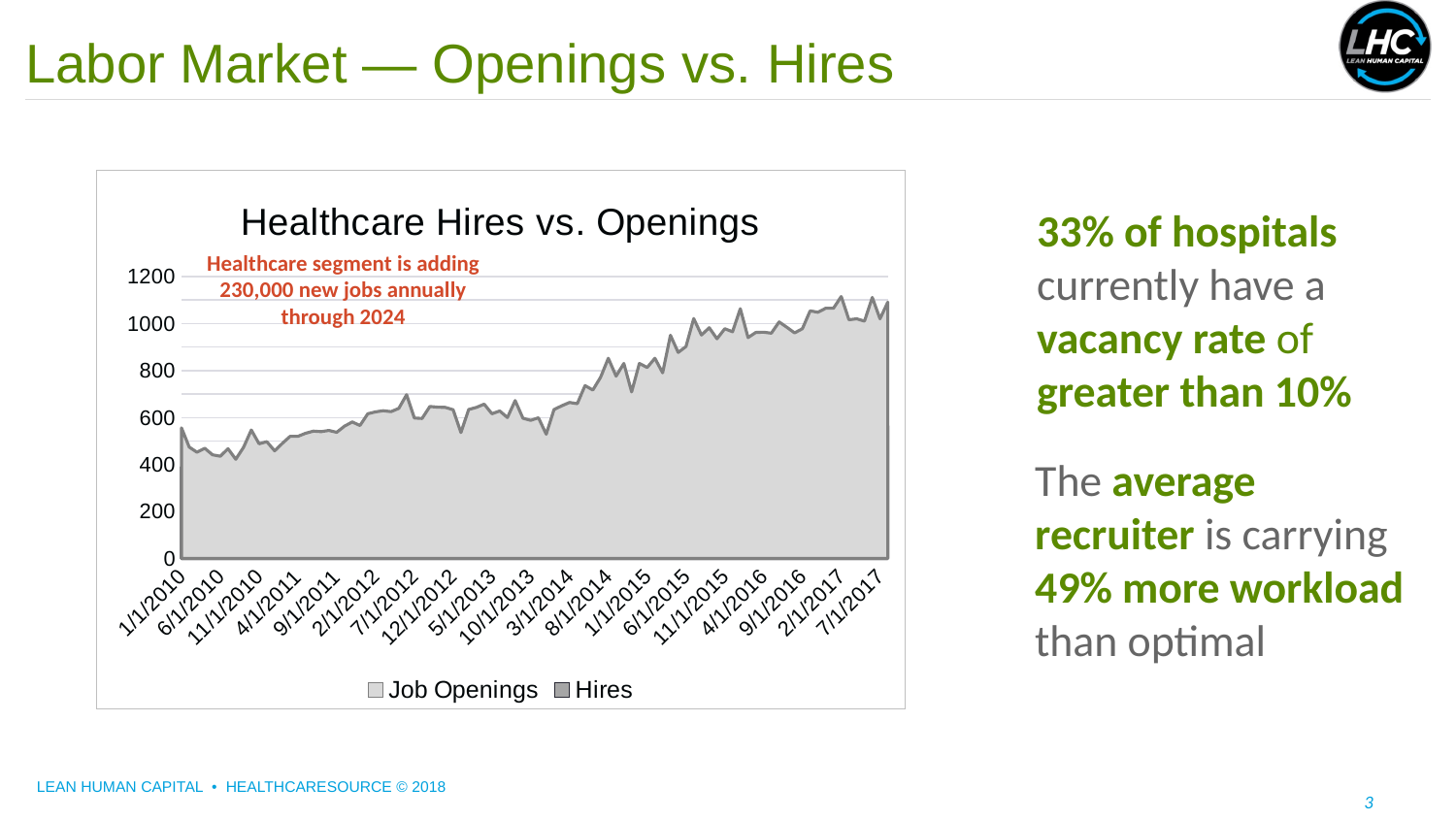
Do the plotted values generally rise or fall from 1/1/2010 to 7/1/2017? Rise Is the value plotted at 4/1/2016 greater or less than 800? greater What kind of chart is shown on the slide? Area chart Is the value plotted at 1/1/2010 greater or less than 400? greater What is the title of the chart on the slide? Healthcare Hires vs. Openings What are the two series named in the chart's legend? Job Openings and Hires How many series does the chart's legend list? 2 Is the value plotted at 9/1/2011 greater or less than 800? less How many date labels are shown along the chart's x axis? 19 What is the highest value shown on the chart's vertical axis? 1200